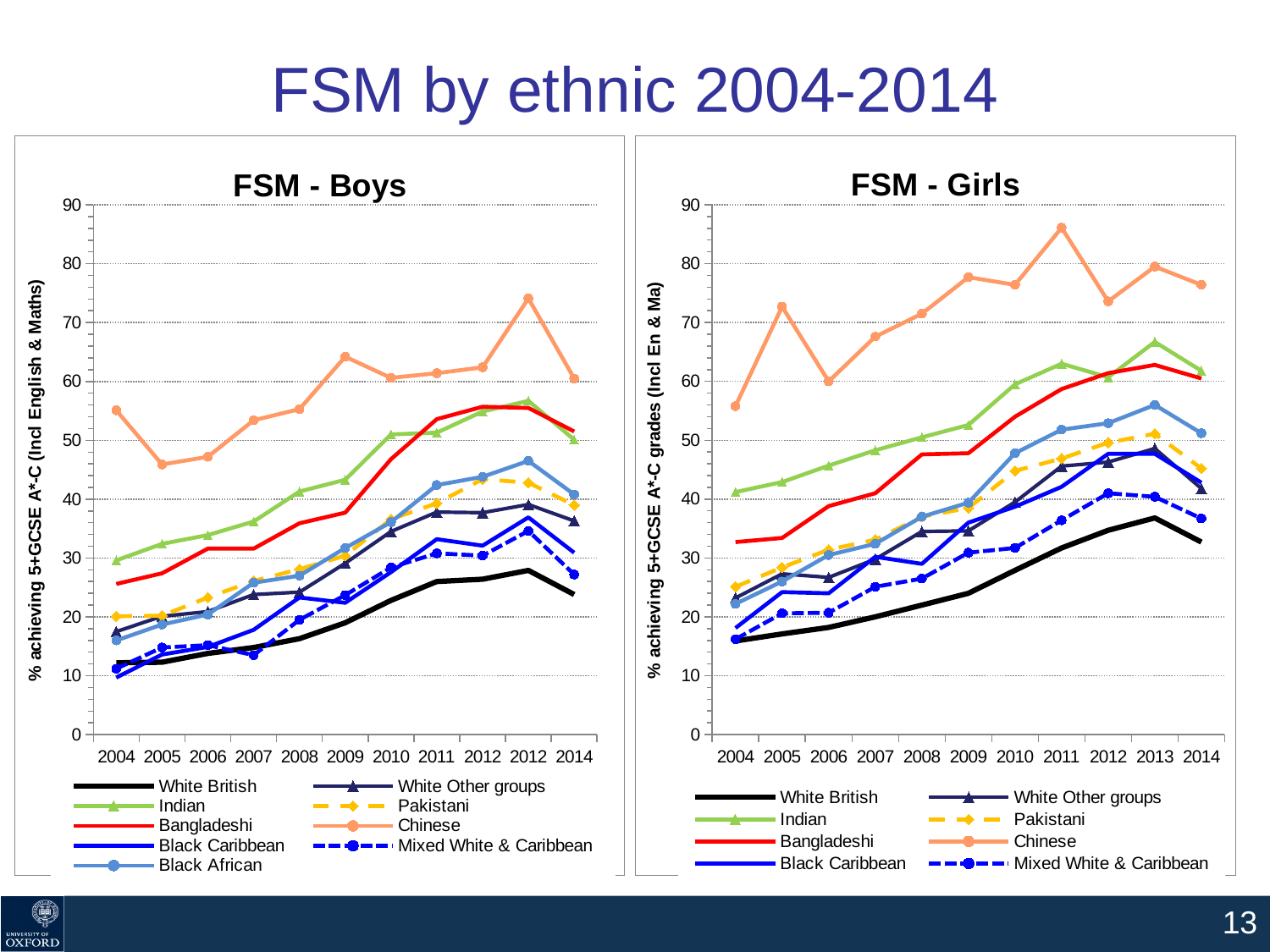
In the FSM - Girls chart, is the value for Chinese in 2005 greater or less than 70? greater In the FSM - Girls chart, is the value for Chinese in 2011 greater or less than 80? greater In the FSM - Girls chart, which series has the highest value in 2011? Chinese How many series does the legend of the FSM - Boys chart list? 9 In the FSM - Girls chart, which is larger in 2004, the value for Indian or the value for White British? Indian What is the y-axis title of the FSM - Boys chart? % achieving 5+GCSE A*-C (Incl English & Maths) How many series does the legend of the FSM - Girls chart list? 8 What kind of chart is the FSM - Boys chart? line chart In the FSM - Boys chart, which is larger in 2009, the value for Chinese or the value for Indian? Chinese In the FSM - Boys chart, is the value for White British in 2004 greater or less than 20? less In the FSM - Girls chart, does the White British line generally rise or fall from 2004 to 2013? rise In the FSM - Boys chart, which series has the highest value in 2004? Chinese